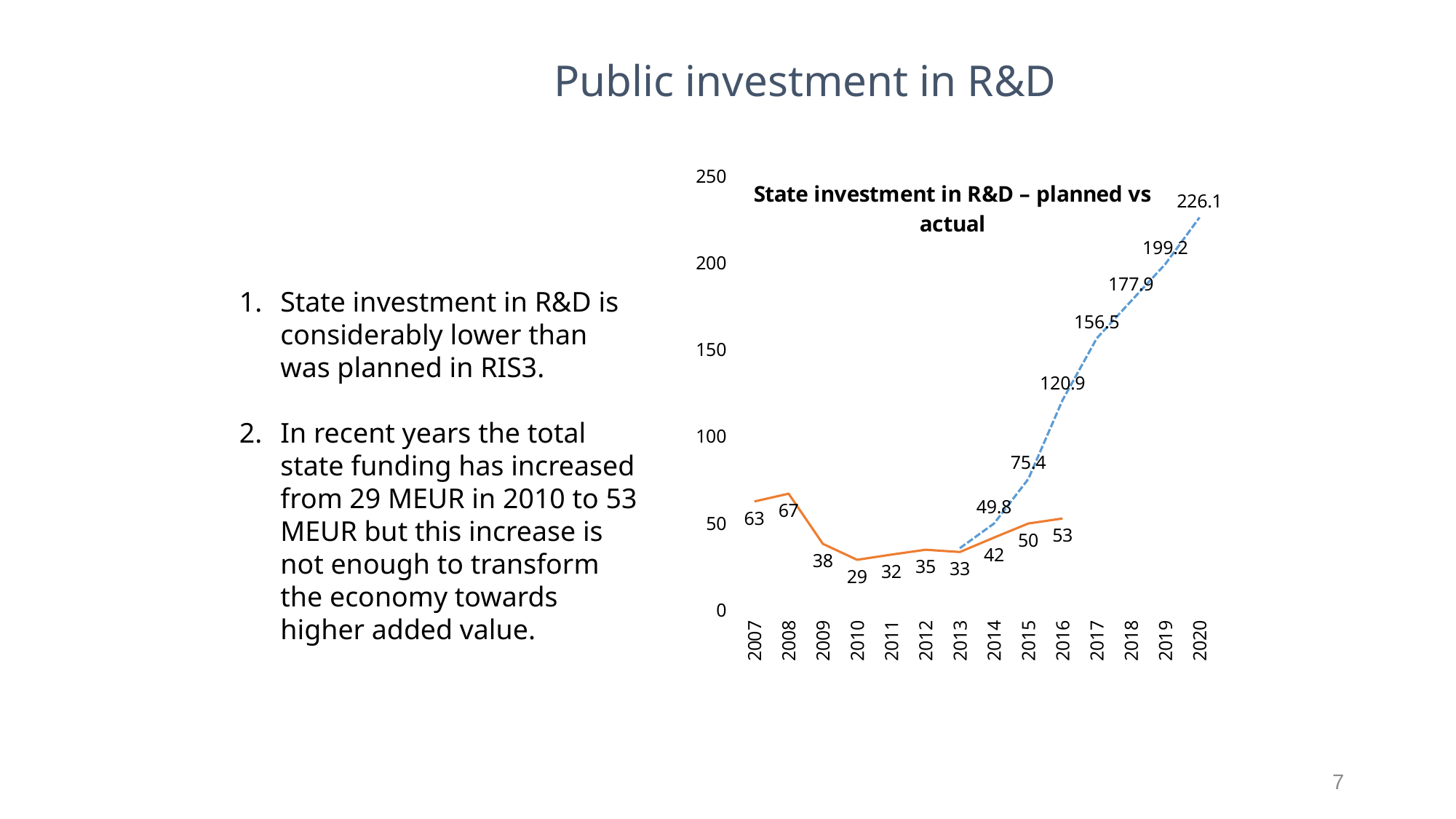
How many years are shown on the x axis? 14 What is the value of the solid orange line for 2016? 53 What is the difference between the dashed blue line and the solid orange line in 2016? 67.9 What is the value of the dashed blue line for 2017? 156.5 What kind of chart is shown on the slide? Line chart What is the value of the dashed blue line for 2020? 226.1 What is the title of the chart? State investment in R&D – planned vs actual Does the dashed blue line rise or fall from 2014 to 2020? Rise In which year does the solid orange line reach its lowest value? 2010 What is the value of the solid orange line for 2010? 29 Which year has the larger value on the solid orange line, 2007 or 2008? 2008 In which year does the solid orange line reach its highest value? 2008